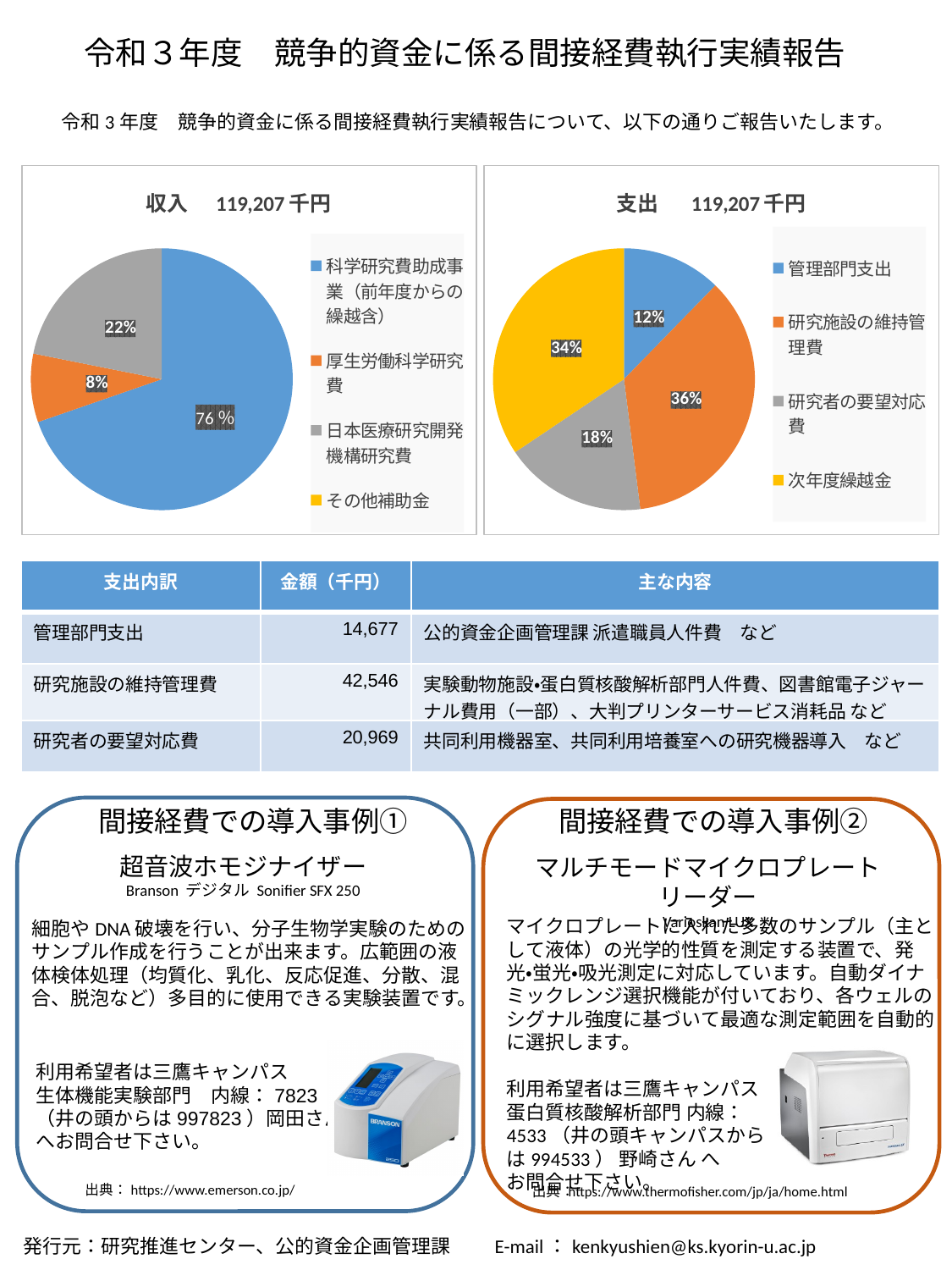
In the 支出 chart, which category has the smallest slice? 管理部門支出 In the 支出 chart, what is the difference in percentage points between 研究施設の維持管理費 and 研究者の要望対応費? 18 In the 支出 chart, which is larger: 次年度繰越金 or 研究者の要望対応費? 次年度繰越金 In the 支出 chart, what percentage is shown for 研究施設の維持管理費? 36% In the 収入 chart, what percentage is shown for 厚生労働科学研究費? 8% How many entries does the legend of the 収入 chart list? 4 In the 収入 chart, what percentage is shown for 科学研究費助成事業（前年度からの繰越含）? 76% In the 支出 chart, what percentage is shown for 次年度繰越金? 34% In the 収入 chart, what percentage is shown for 日本医療研究開発機構研究費? 22% In the 収入 chart, which category has the largest slice? 科学研究費助成事業（前年度からの繰越含） What kind of chart is the 収入 chart on the left? pie chart In the 支出 chart, what percentage is shown for 管理部門支出? 12%